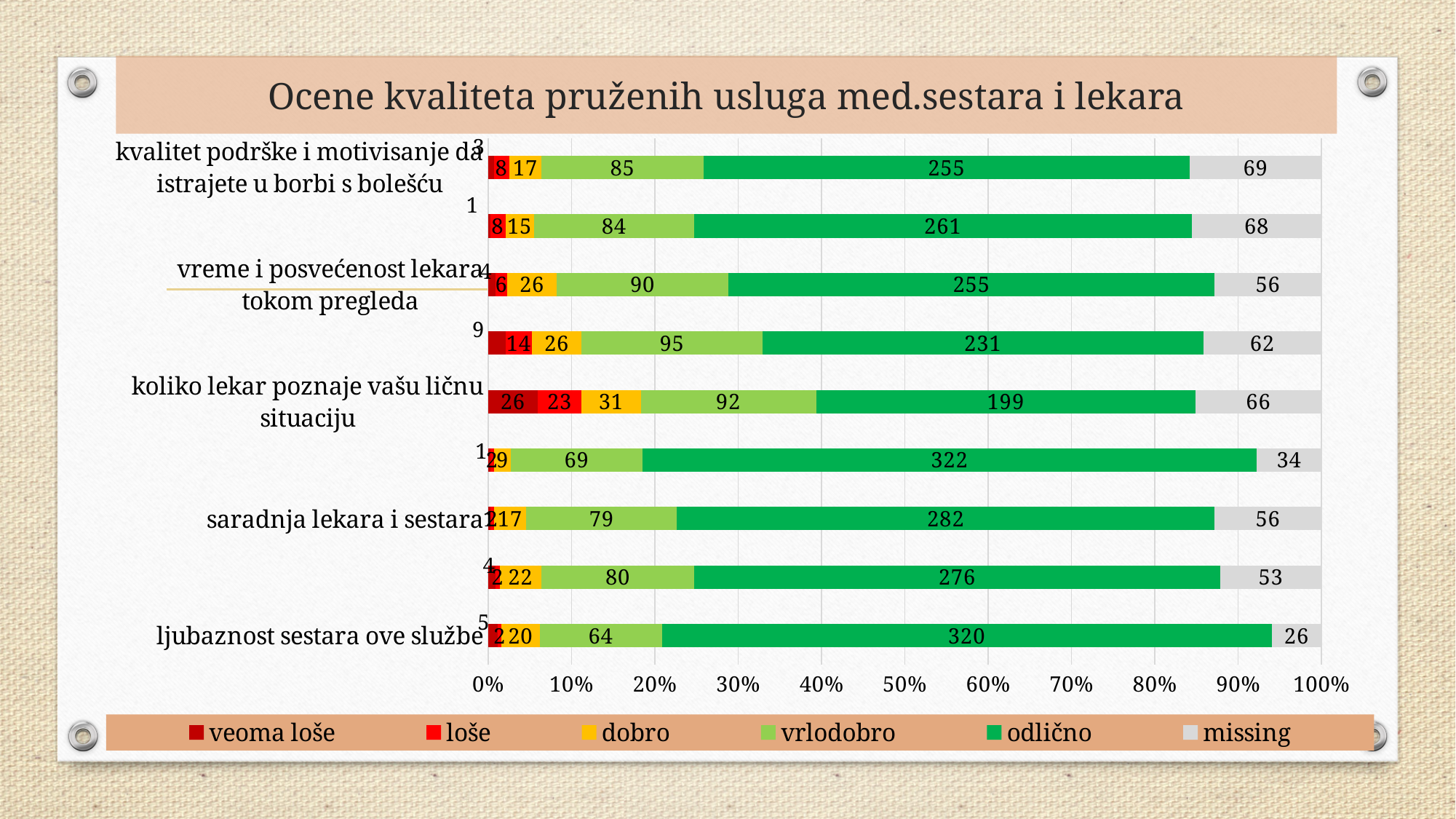
What is the 'missing' value for 'kvalitet podrške i motivisanje da istrajete u borbi s bolešću'? 69 What is the 'veoma loše' value for 'koliko lekar poznaje vašu ličnu situaciju'? 26 What is the 'odlično' value for 'ljubaznost sestara ove službe'? 320 What is the difference between the 'missing' value for 'kvalitet podrške i motivisanje da istrajete u borbi s bolešću' and the 'missing' value for 'ljubaznost sestara ove službe'? 43 What colour represents the 'missing' series in the legend? grey What kind of chart is shown on the slide? stacked bar chart Which has the larger 'odlično' value: 'ljubaznost sestara ove službe' or 'koliko lekar poznaje vašu ličnu situaciju'? ljubaznost sestara ove službe What is the total of all segments in the bar for 'koliko lekar poznaje vašu ličnu situaciju'? 437 What is the 'odlično' value for 'saradnja lekara i sestara'? 282 How many bars (categories) are plotted in the chart? 9 How many series does the legend list? 6 What is the 'vrlodobro' value for 'vreme i posvećenost lekara tokom pregleda'? 90